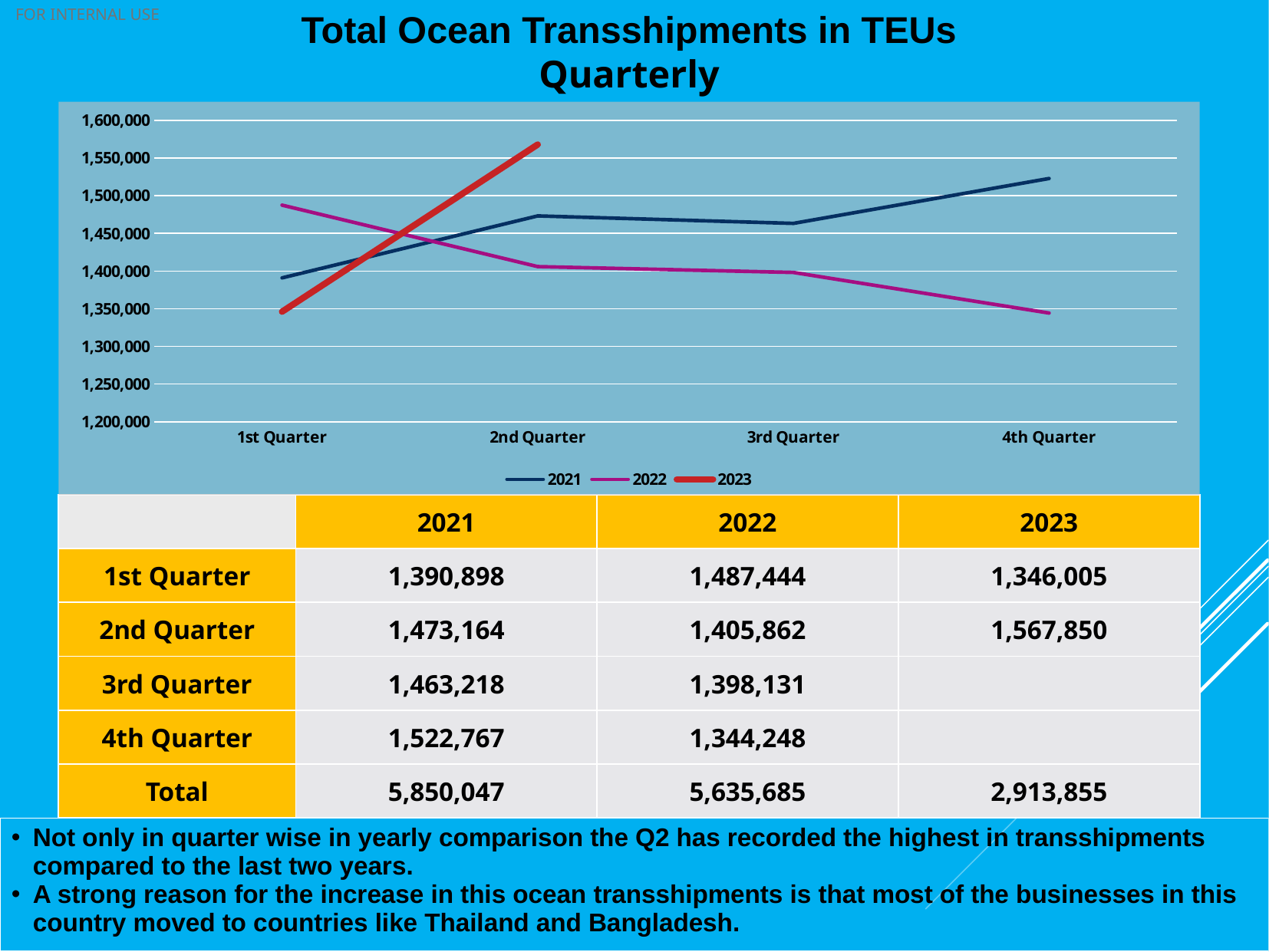
Which is larger in the 1st Quarter, the 2021 value or the 2022 value? 2022 How many quarters are plotted along the x axis? 4 What is the value for 2023 in the 2nd Quarter? 1,567,850 What is the difference between the 2023 and 2021 values in the 2nd Quarter? 94,686 How many series does the chart legend list? 3 What kind of chart is shown on the slide? line chart In which quarter does the 2021 series reach its highest value? 4th Quarter What is the value for 2022 in the 3rd Quarter? 1,398,131 Does the 2022 series rise or fall from the 1st Quarter to the 4th Quarter? fall Is the 2023 value for the 2nd Quarter greater or less than 1,550,000? greater What is the value for 2021 in the 4th Quarter? 1,522,767 In which quarter does the 2022 series reach its lowest value? 4th Quarter